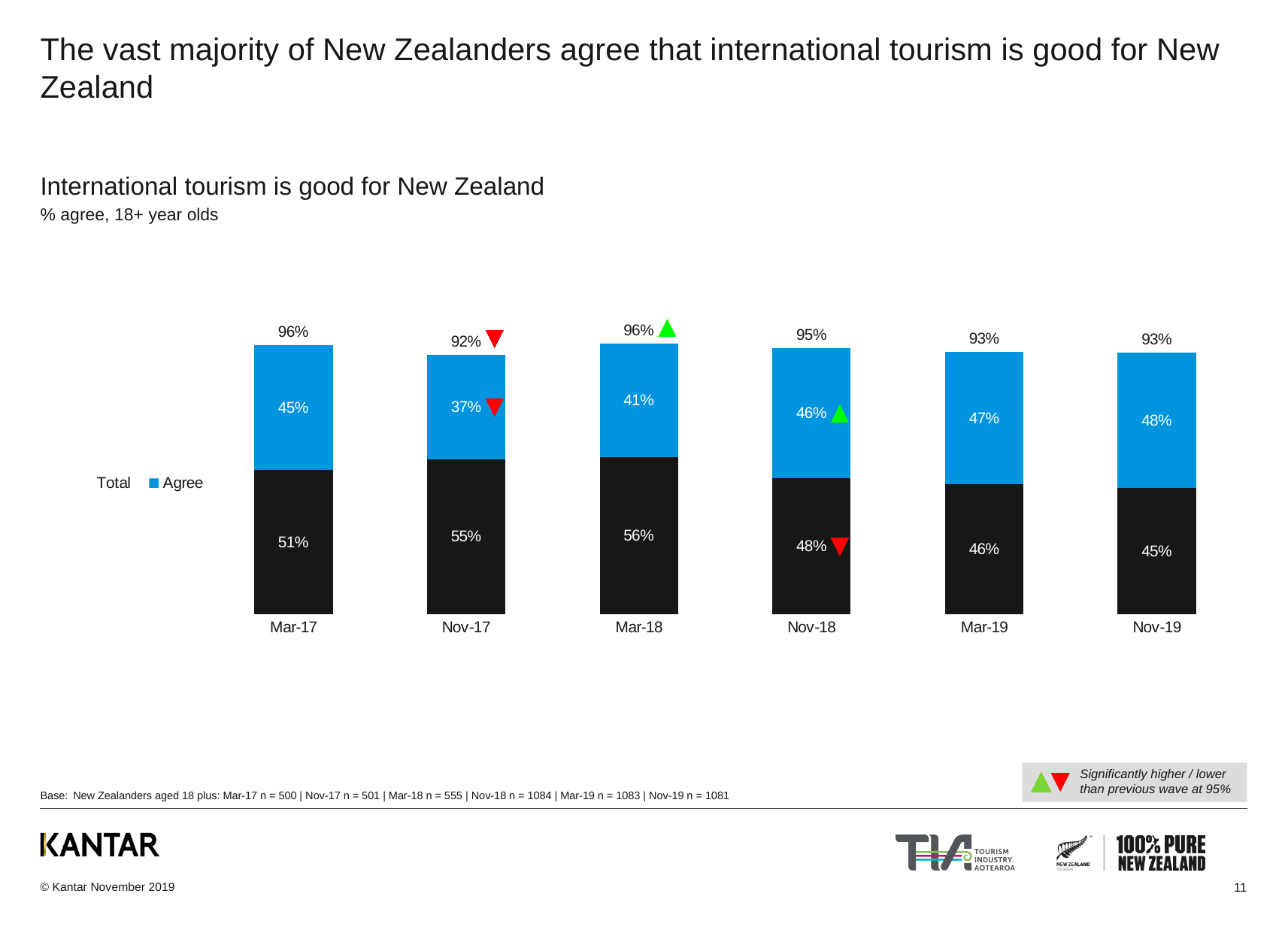
What kind of chart is shown on the slide? Stacked bar chart What is the value of the blue (Agree) segment for Nov-19? 48% What is the total value shown above the Mar-17 bar? 96% Which period has the highest value for the black segment? Mar-18 Does the total value rise or fall from Mar-17 to Nov-19? Fall What is the value of the blue (Agree) segment for Nov-17? 37% What is the subtitle text shown directly below the chart title 'International tourism is good for New Zealand'? % agree, 18+ year olds Which period has the lowest total value shown above its bar? Nov-17 How many periods are shown on the x axis? 6 What is the value of the black segment for Mar-18? 56% What is the difference between the total for Mar-17 and the total for Nov-17? 4% Is the blue (Agree) segment larger for Mar-19 or for Nov-17? Mar-19